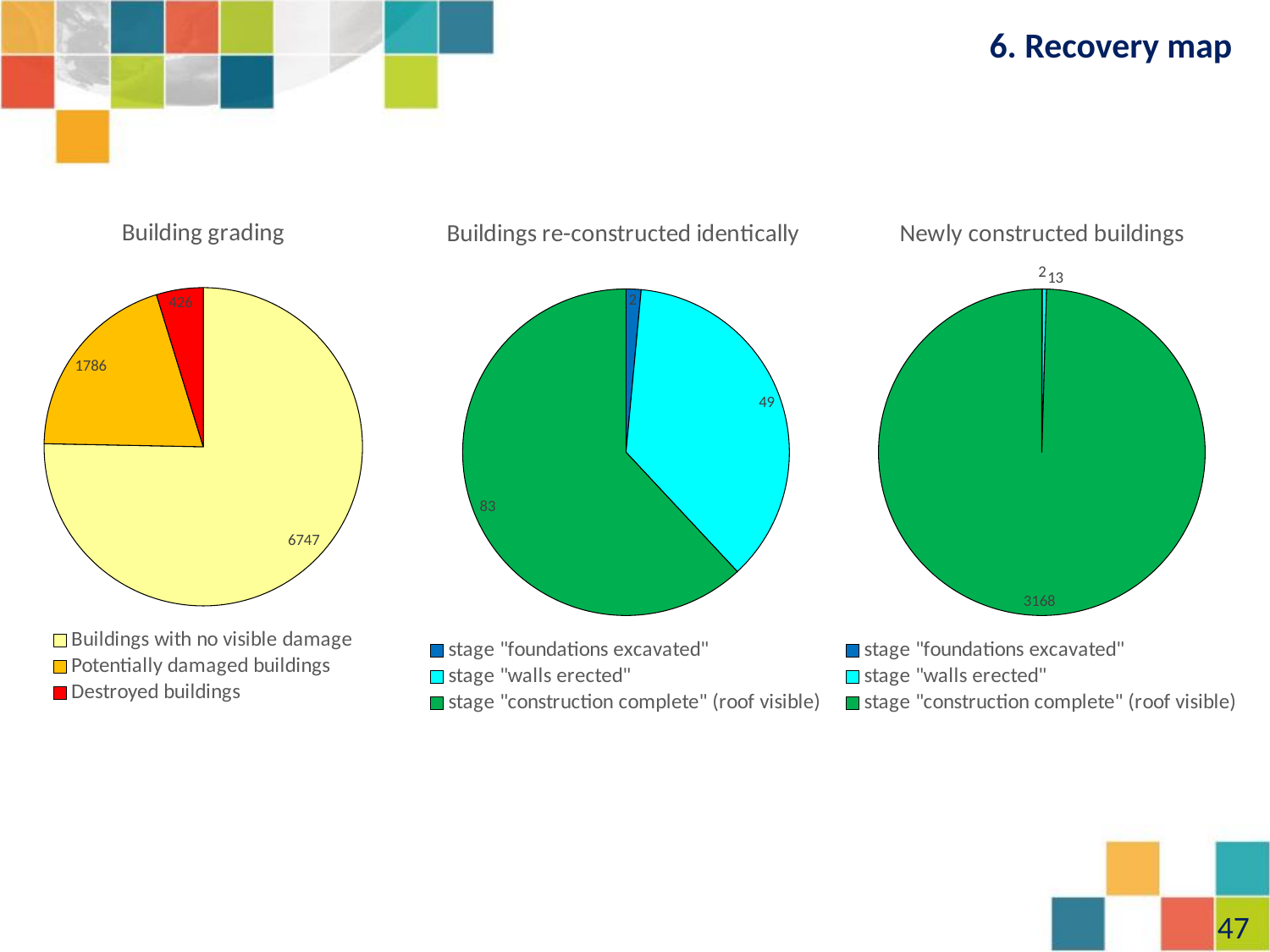
In the 'Building grading' chart, how many buildings have no visible damage? 6747 In the 'Newly constructed buildings' chart, what is the value for stage "construction complete" (roof visible)? 3168 What type of chart is 'Newly constructed buildings'? Pie chart In the 'Buildings re-constructed identically' chart, what is the total of all three slices? 134 In the 'Newly constructed buildings' chart, what is the value for stage "walls erected"? 13 Which is larger: stage "walls erected" in 'Buildings re-constructed identically' or stage "walls erected" in 'Newly constructed buildings'? Buildings re-constructed identically In the 'Buildings re-constructed identically' chart, which stage has the largest slice? stage "construction complete" (roof visible) In the 'Buildings re-constructed identically' chart, what is the value for stage "walls erected"? 49 In the 'Building grading' chart, what is the value for destroyed buildings? 426 In the 'Building grading' chart, what is the difference between potentially damaged buildings and destroyed buildings? 1360 In the 'Building grading' chart, which category has the smallest slice? Destroyed buildings How many categories does the 'Building grading' chart show? 3